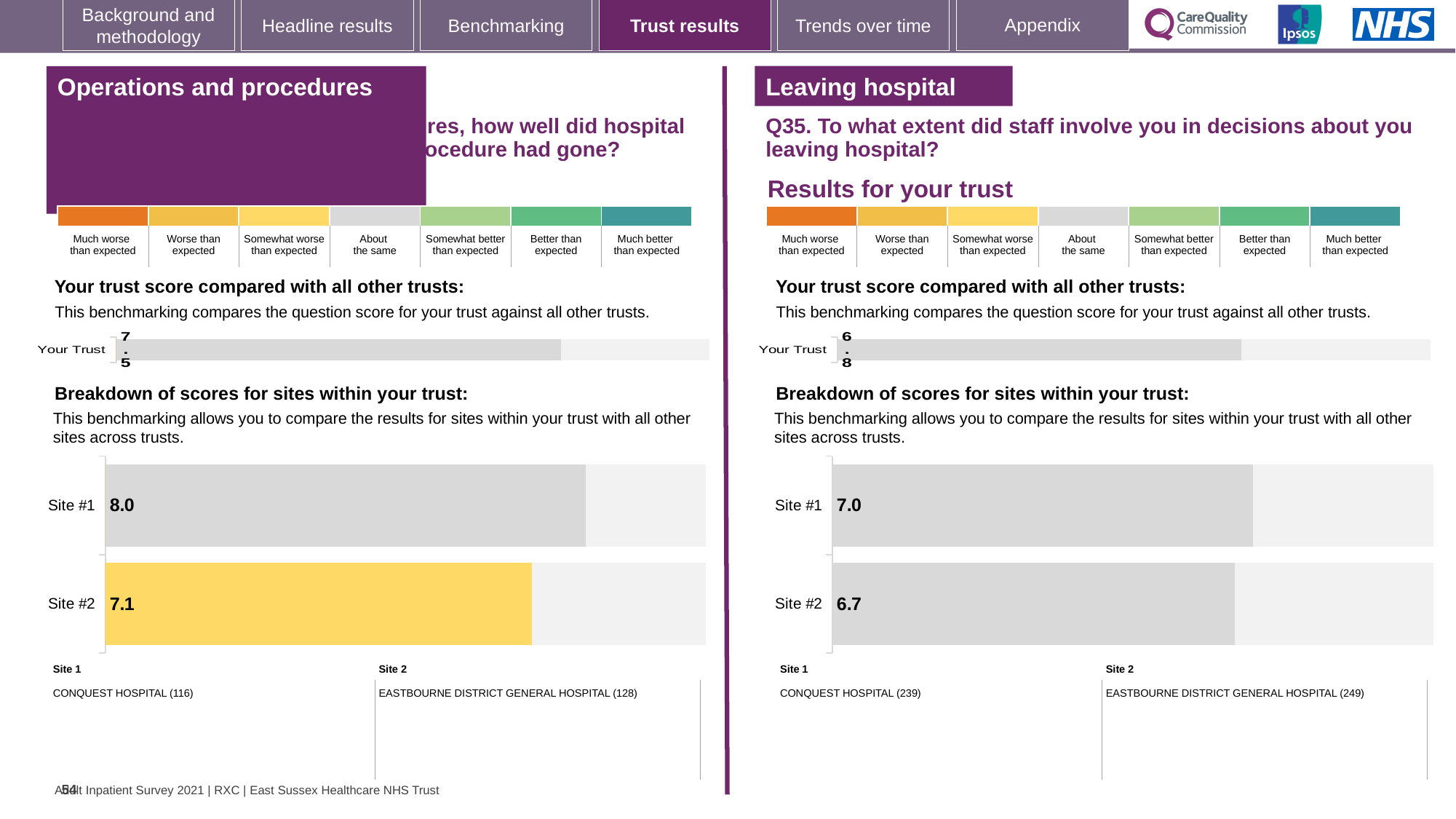
In the 'Leaving hospital' site breakdown chart on the right, what is the score for Site #2? 6.7 In the 'Operations and procedures' trust score chart on the left, what is the score for Your Trust? 7.5 In the 'Operations and procedures' site breakdown chart on the left, what is the score for Site #1? 8.0 In the 'Leaving hospital' site breakdown chart on the right, what is the score for Site #1? 7.0 In the 'Leaving hospital' trust score chart on the right, what is the score for Your Trust? 6.8 How many sites are shown in the 'Leaving hospital' site breakdown chart on the right? 2 In the 'Operations and procedures' site breakdown chart on the left, what is the difference between the Site #1 and Site #2 scores? 0.9 In the 'Operations and procedures' site breakdown chart on the left, which site has the higher score? Site #1 In the 'Operations and procedures' site breakdown chart on the left, what is the score for Site #2? 7.1 In the 'Leaving hospital' site breakdown chart on the right, what is the difference between the Site #1 and Site #2 scores? 0.3 In the 'Leaving hospital' site breakdown chart on the right, which site has the lower score? Site #2 What type of chart is used for the site breakdown in the 'Operations and procedures' section on the left? Bar chart